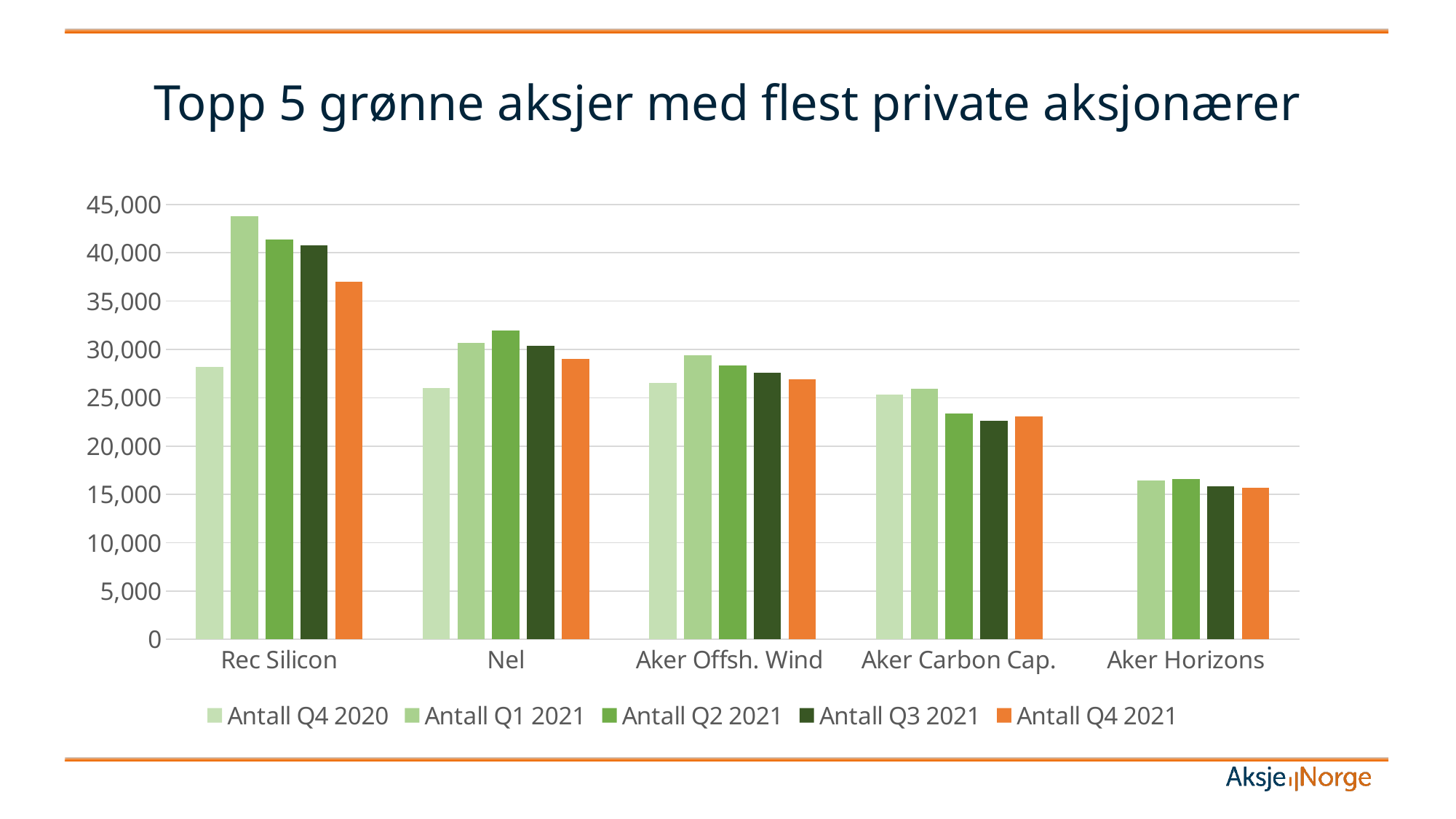
How many series does the legend list? 5 How many companies are shown on the x axis? 5 Is the Antall Q1 2021 value for Rec Silicon greater or less than 40,000? greater What is the title of the chart? Topp 5 grønne aksjer med flest private aksjonærer What colour represents the Antall Q4 2021 series? Orange Which company has the lowest value for Antall Q4 2021? Aker Horizons For Rec Silicon, do the values rise or fall from Antall Q1 2021 to Antall Q4 2021? Fall For Rec Silicon, which is larger: Antall Q4 2020 or Antall Q1 2021? Antall Q1 2021 Is the Antall Q4 2020 value for Nel greater or less than 30,000? less What kind of chart is shown on the slide? Bar chart Is the Antall Q3 2021 value for Aker Carbon Cap. greater or less than 25,000? less Which company has the highest value for Antall Q1 2021? Rec Silicon